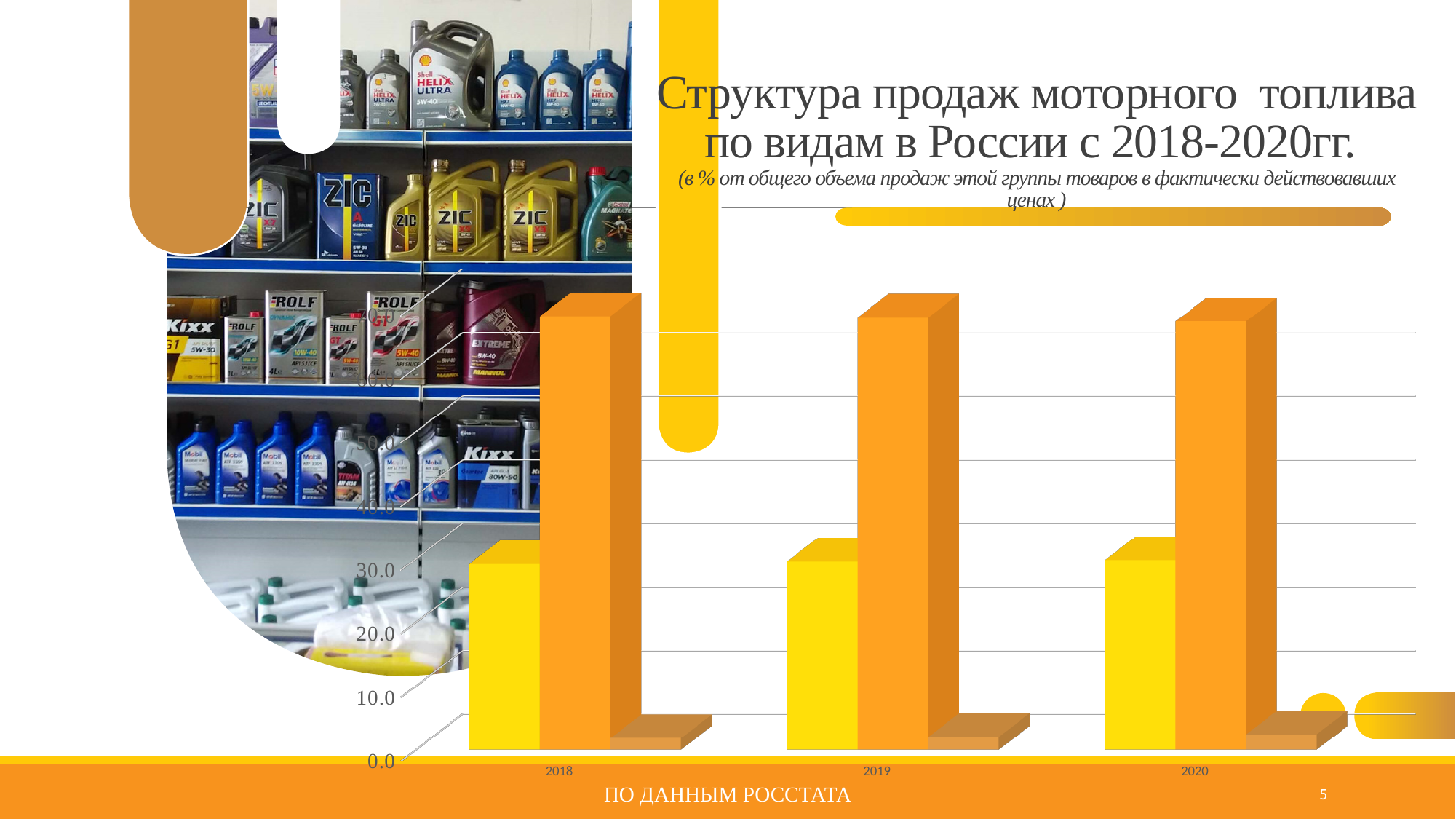
How many bars are plotted for each year in the chart? 3 In 2019, which bar is taller: the orange bar or the yellow bar? The orange bar Is the value of the yellow bar for 2019 greater or less than 40? less How many years (categories) are shown on the x axis of the chart? 3 Which bar is the lowest for 2020: yellow, orange or brown? Brown Is the value of the orange bar for 2020 greater or less than 50? greater Is the value of the yellow bar for 2018 greater or less than 20? greater Which years are shown on the x axis of the chart? 2018, 2019, 2020 What kind of chart is shown on the slide? Bar chart According to the footer, what is the data source for the chart? По данным Росстата